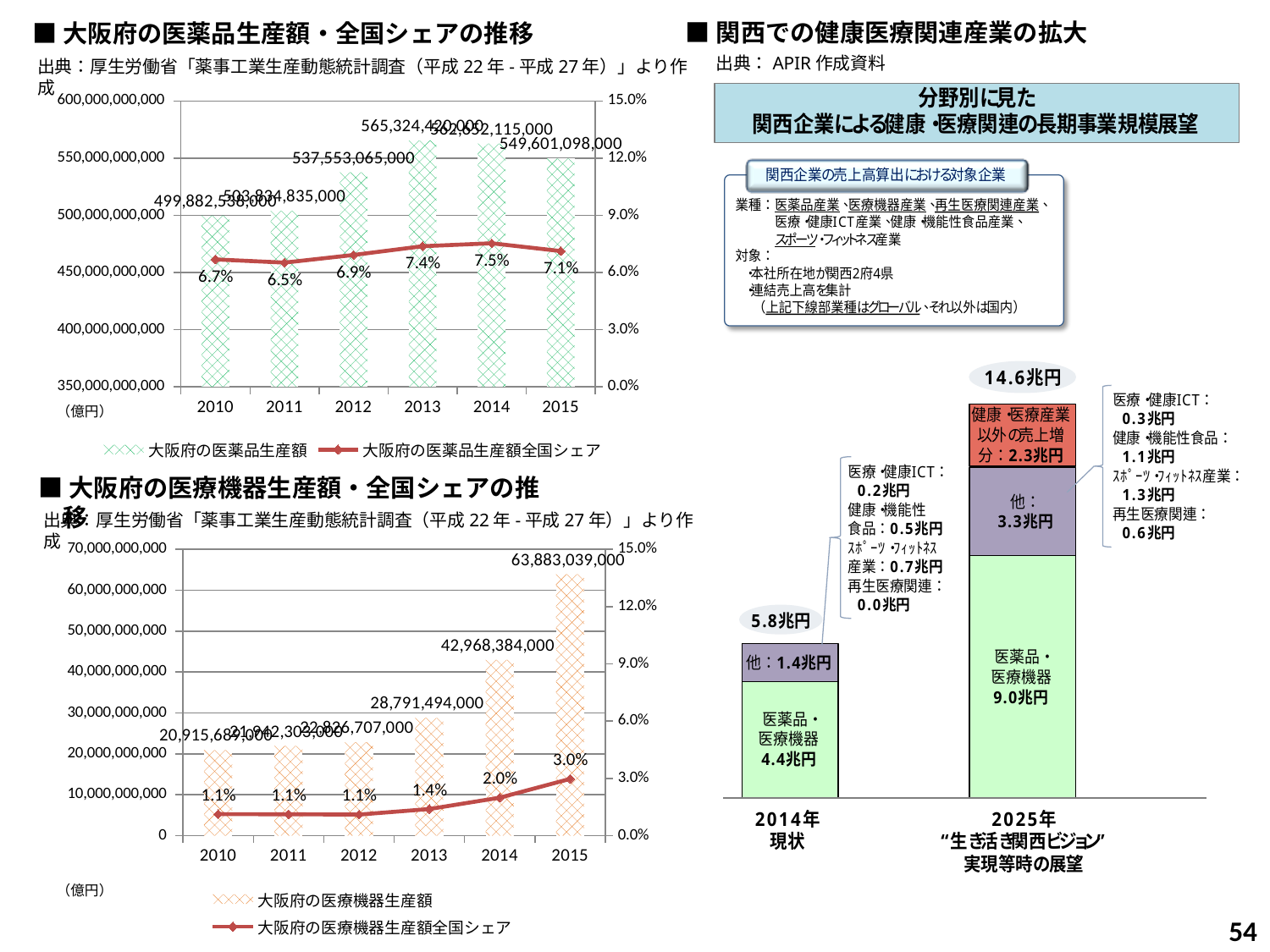
In the bottom-left chart (大阪府の医療機器生産額・全国シェアの推移), which year has the highest medical device production value? 2015 In the bottom-left chart (大阪府の医療機器生産額・全国シェアの推移), does the medical device production value rise or fall from 2010 to 2015? rise In the top-left chart (大阪府の医薬品生産額・全国シェアの推移), what is the pharmaceutical production value for 2015? 549,601,098,000 In the bottom-left chart (大阪府の医療機器生産額・全国シェアの推移), what is the national share for 2015? 3.0% In the top-left chart (大阪府の医薬品生産額・全国シェアの推移), how many years are shown on the x axis? 6 In the top-left chart (大阪府の医薬品生産額・全国シェアの推移), what is the difference in national share between 2014 and 2011? 1.0 percentage points In the top-left chart (大阪府の医薬品生産額・全国シェアの推移), how many series does the legend list? 2 In the top-left chart (大阪府の医薬品生産額・全国シェアの推移), what is the national share (全国シェア) for 2014? 7.5% In the top-left chart (大阪府の医薬品生産額・全国シェアの推移), what is the pharmaceutical production value for 2012? 537,553,065,000 In the top-left chart (大阪府の医薬品生産額・全国シェアの推移), which year has the lowest national share? 2011 In the bottom-left chart (大阪府の医療機器生産額・全国シェアの推移), what kind of chart is used? Combination bar and line chart In the bottom-left chart (大阪府の医療機器生産額・全国シェアの推移), what is the medical device production value for 2015? 63,883,039,000